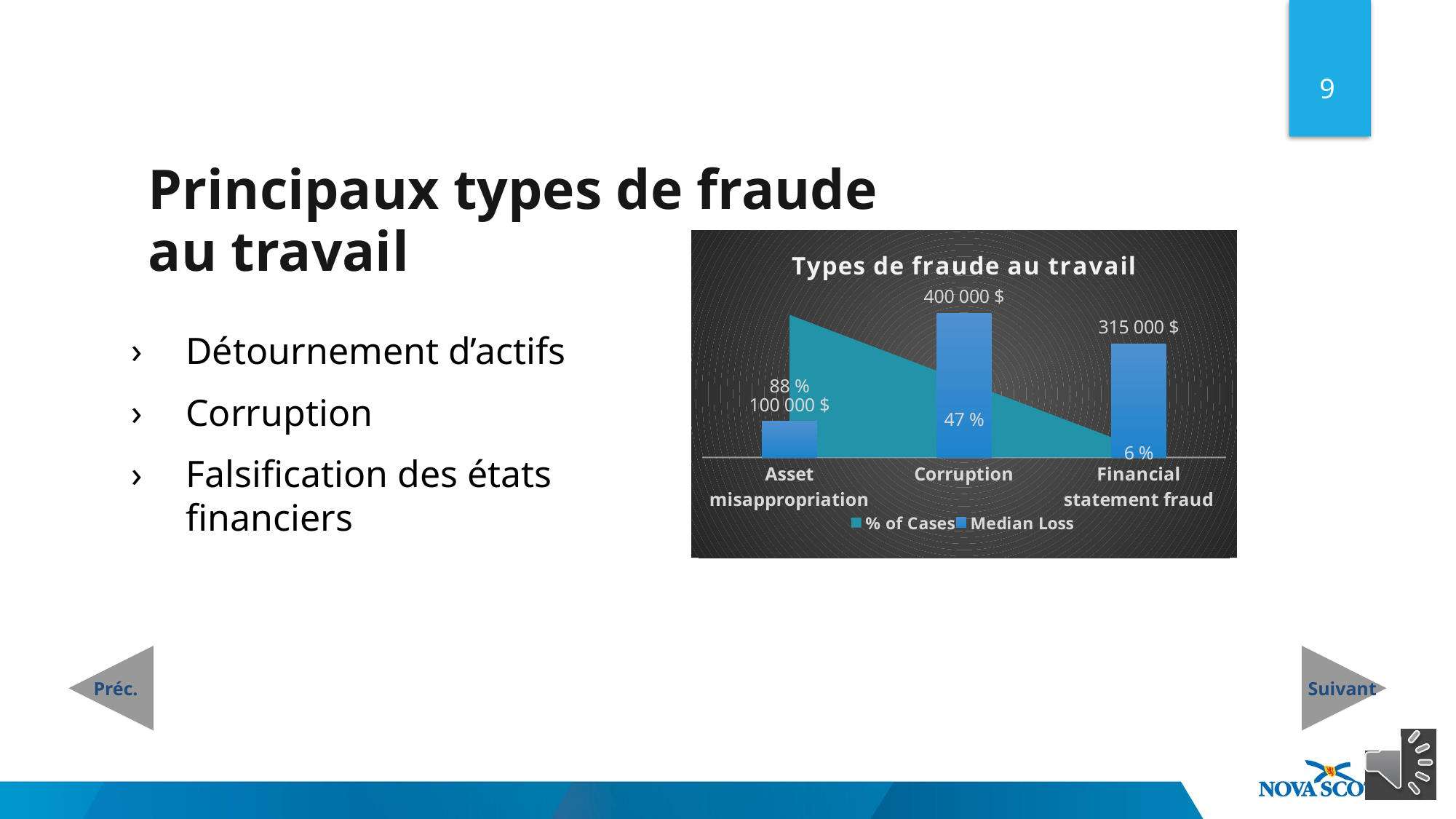
Does the % of Cases rise or fall from Asset misappropriation to Financial statement fraud? fall What is the % of Cases for Asset misappropriation? 88 % Which category has the highest Median Loss? Corruption Which has a higher % of Cases, Corruption or Financial statement fraud? Corruption How many series does the legend list? 2 What is the % of Cases for Financial statement fraud? 6 % What is the Median Loss for Financial statement fraud? 315 000 $ What is the Median Loss for Asset misappropriation? 100 000 $ Which category has the lowest % of Cases? Financial statement fraud What is the title of the chart? Types de fraude au travail What is the difference in Median Loss between Corruption and Financial statement fraud? 85 000 $ What is the Median Loss for Corruption? 400 000 $